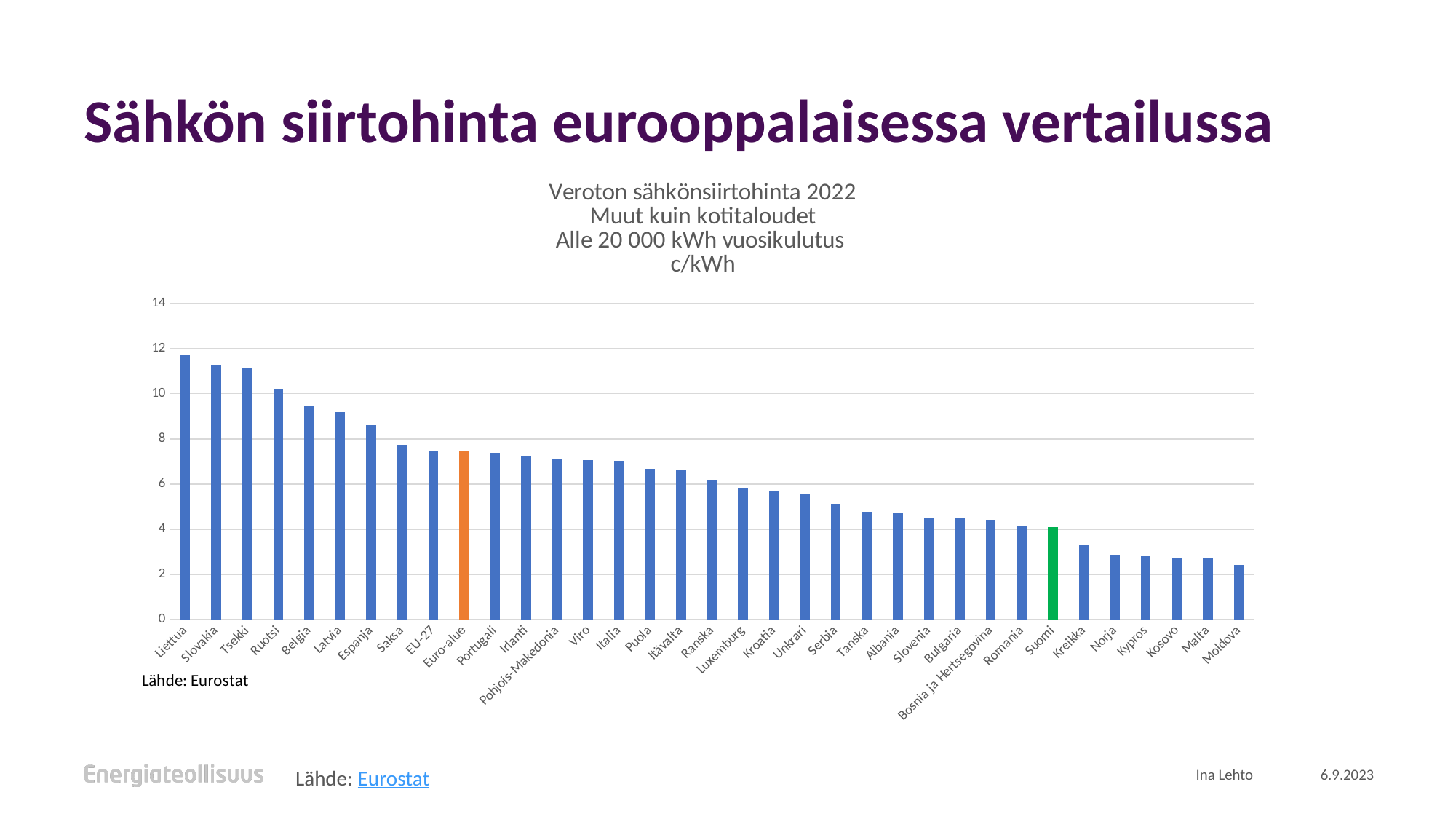
Is the value for Suomi greater or less than 6? less Is the value for Kreikka greater or less than 4? less Is the value for Belgia greater or less than 8? greater Which country's bar is coloured green in the chart? Suomi Do the values rise or fall from left to right along the x axis? fall How many countries or regions are shown on the x axis of the chart? 35 Which has a higher value, Ruotsi or Suomi? Ruotsi Which country has the highest electricity transmission price in the chart? Liettua What kind of chart is shown on the slide? bar chart Which country has the lowest electricity transmission price in the chart? Moldova